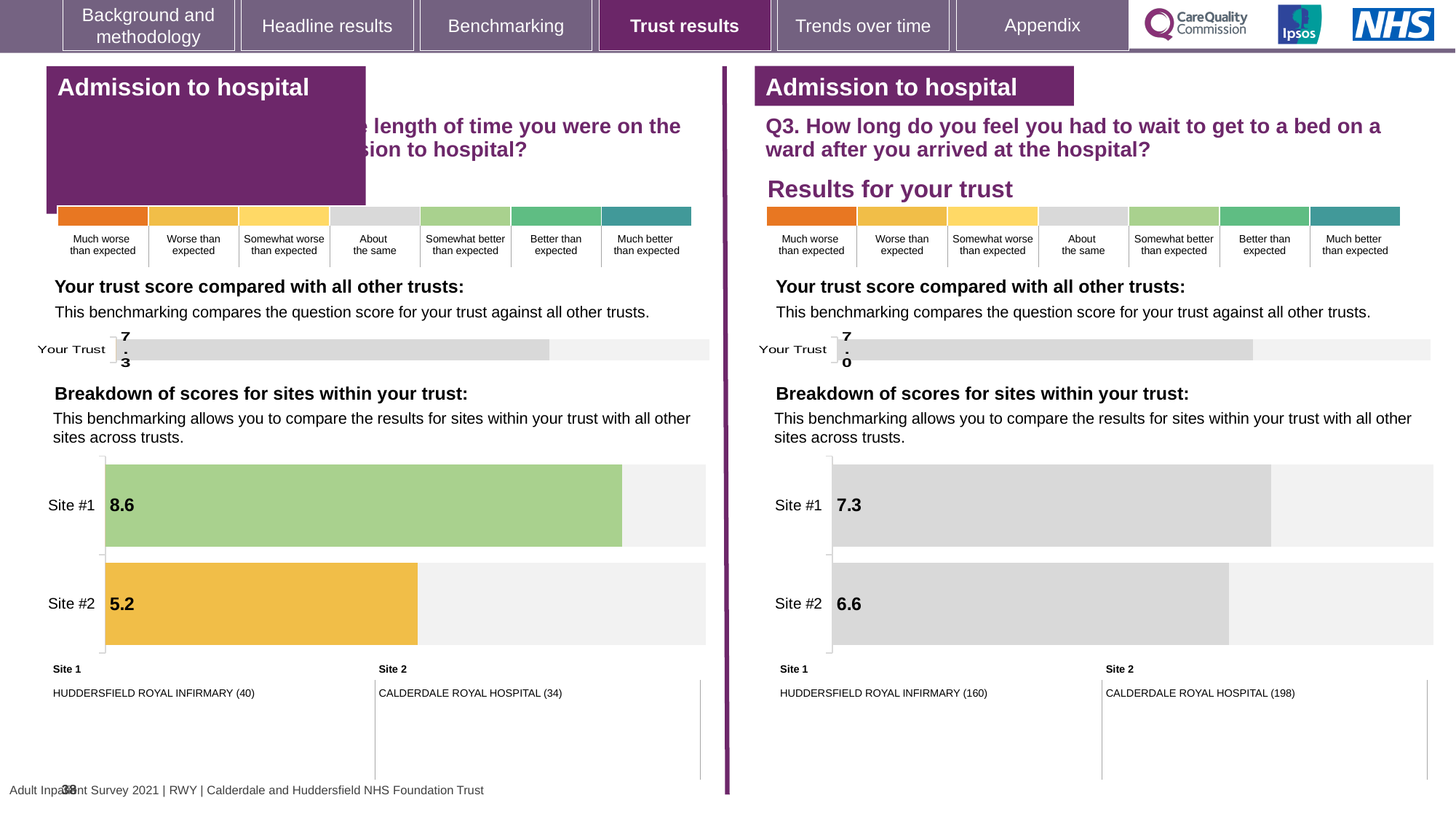
On the left-hand panel's site breakdown chart, what is the score for Site #1? 8.6 On the right-hand panel (Q3) site breakdown chart, what is the difference between the Site #1 and Site #2 scores? 0.7 On the right-hand panel (Q3) 'Your trust score compared with all other trusts' chart, what is the score shown for Your Trust? 7.0 How many sites are shown in the left-hand panel's site breakdown chart? 2 On the right-hand panel (Q3) site breakdown chart, which site has the lower score? Site #2 On the left-hand panel's site breakdown chart, which site has the higher score? Site #1 On the left-hand panel's site breakdown chart, what is the difference between the Site #1 and Site #2 scores? 3.4 On the left-hand panel's site breakdown chart, what is the score for Site #2? 5.2 On the right-hand panel (Q3) site breakdown chart, what is the score for Site #1? 7.3 What type of chart is used for the site breakdown on the right-hand panel (Q3)? Bar chart On the left-hand panel's 'Your trust score compared with all other trusts' chart, what is the score shown for Your Trust? 7.3 On the right-hand panel (Q3) site breakdown chart, what is the score for Site #2? 6.6